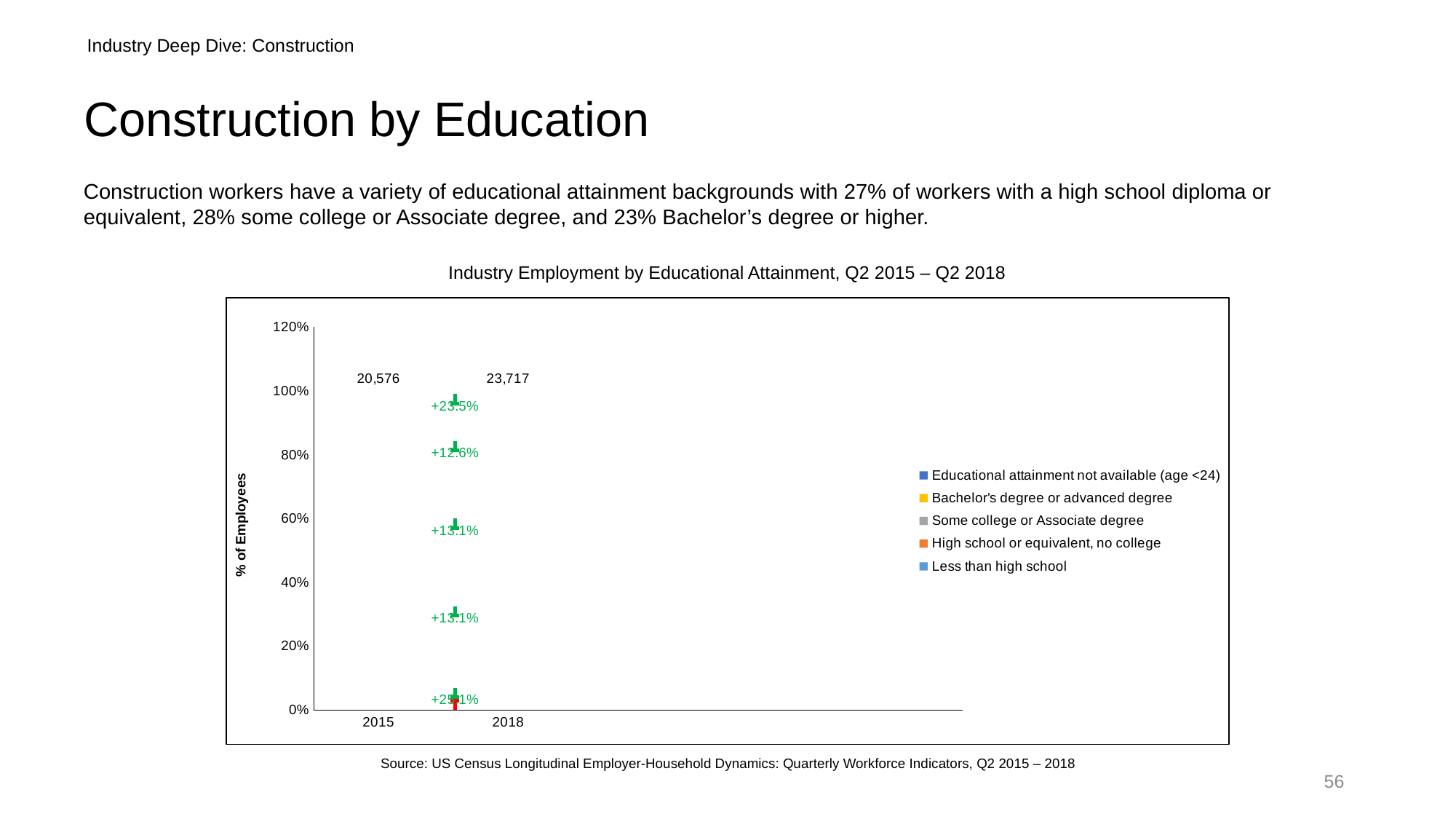
What is the smallest percentage change label printed between the 2015 and 2018 columns? +12.6% How many series does the chart's legend list? 5 What is the label of the y axis? % of Employees What is the largest percentage change label printed between the 2015 and 2018 columns? +25.1% What total employment figure is printed above the 2018 column? 23,717 Does the total employment figure rise or fall from 2015 to 2018? rise What is the difference between the 2018 and 2015 total employment figures? 3,141 Which year has the larger total employment figure, 2015 or 2018? 2018 How many years are shown on the x axis of the chart? 2 What total employment figure is printed above the 2015 column? 20,576 What is the title of the chart? Industry Employment by Educational Attainment, Q2 2015 – Q2 2018